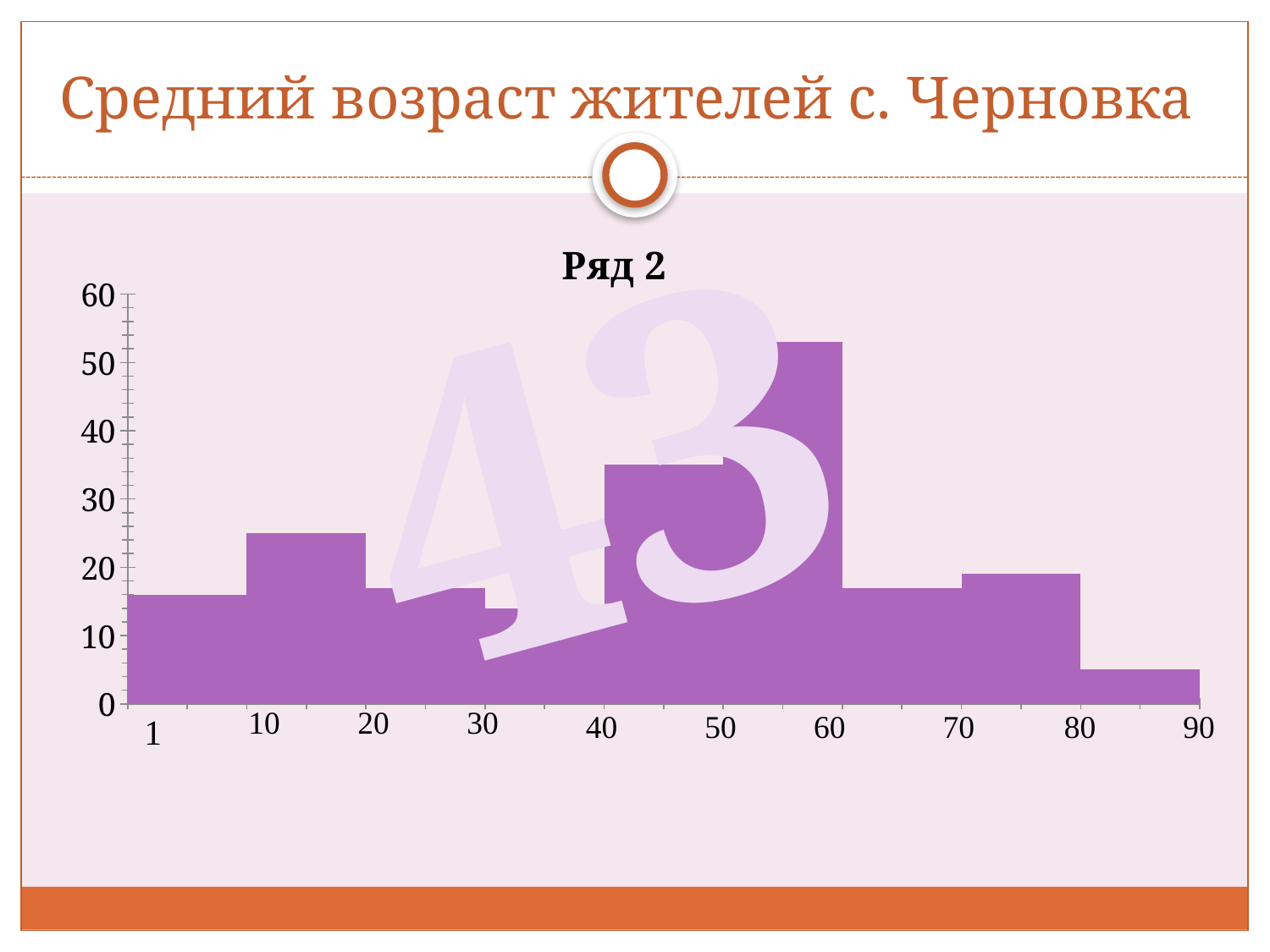
What colour are the bars in the chart? purple Which age interval on the x axis has the shortest bar? 80 to 90 What is the title shown above the chart? Ряд 2 Which bar is taller: the one between 10 and 20 or the one between 20 and 30? 10 to 20 Is the value of the bar between 40 and 50 greater or less than 30? greater Is the value of the bar between 10 and 20 greater or less than 20? greater What kind of chart is shown on the slide? bar chart Which age interval on the x axis has the tallest bar? 50 to 60 How many bars are plotted in the chart? 9 Is the value of the bar between 1 and 10 greater or less than 20? less